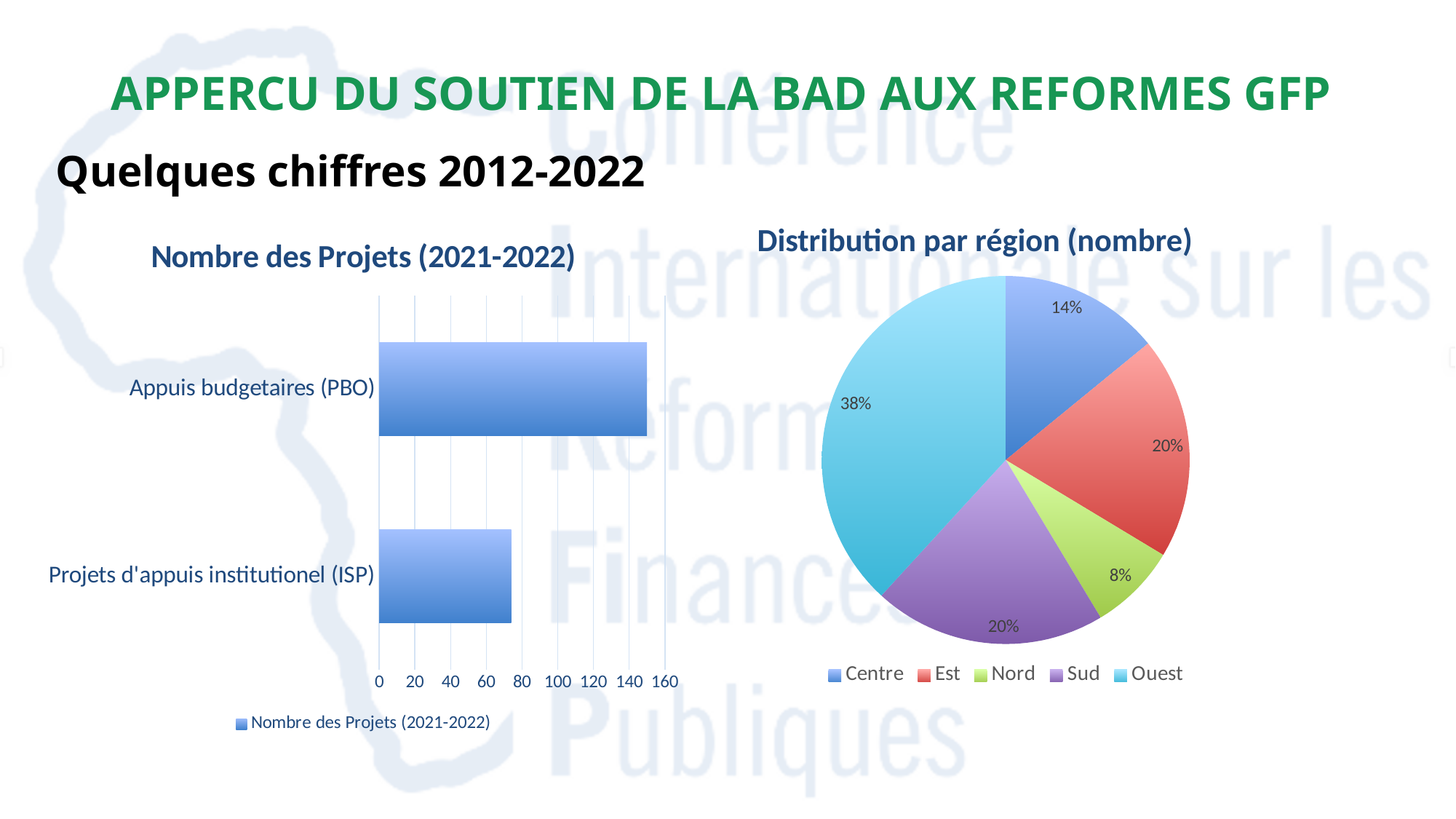
In the "Distribution par région (nombre)" chart, which region has the largest share? Ouest In the "Distribution par région (nombre)" chart, which region has the smallest share? Nord How many regions are listed in the legend of the "Distribution par région (nombre)" chart? 5 In the "Distribution par région (nombre)" chart, what is the difference between the shares of Ouest and Nord? 30% In the "Nombre des Projets (2021-2022)" chart, is the value for Projets d'appuis institutionel (ISP) greater or less than 80? less In the "Nombre des Projets (2021-2022)" chart, which category has the higher value? Appuis budgetaires (PBO) In the "Nombre des Projets (2021-2022)" chart, is the value for Appuis budgetaires (PBO) greater or less than 140? greater What kind of chart is "Distribution par région (nombre)"? pie chart In the "Nombre des Projets (2021-2022)" chart, how many categories are shown? 2 In the "Distribution par région (nombre)" chart, what share does Centre have? 14% In the "Distribution par région (nombre)" chart, what share does Ouest have? 38% What kind of chart is "Nombre des Projets (2021-2022)"? bar chart